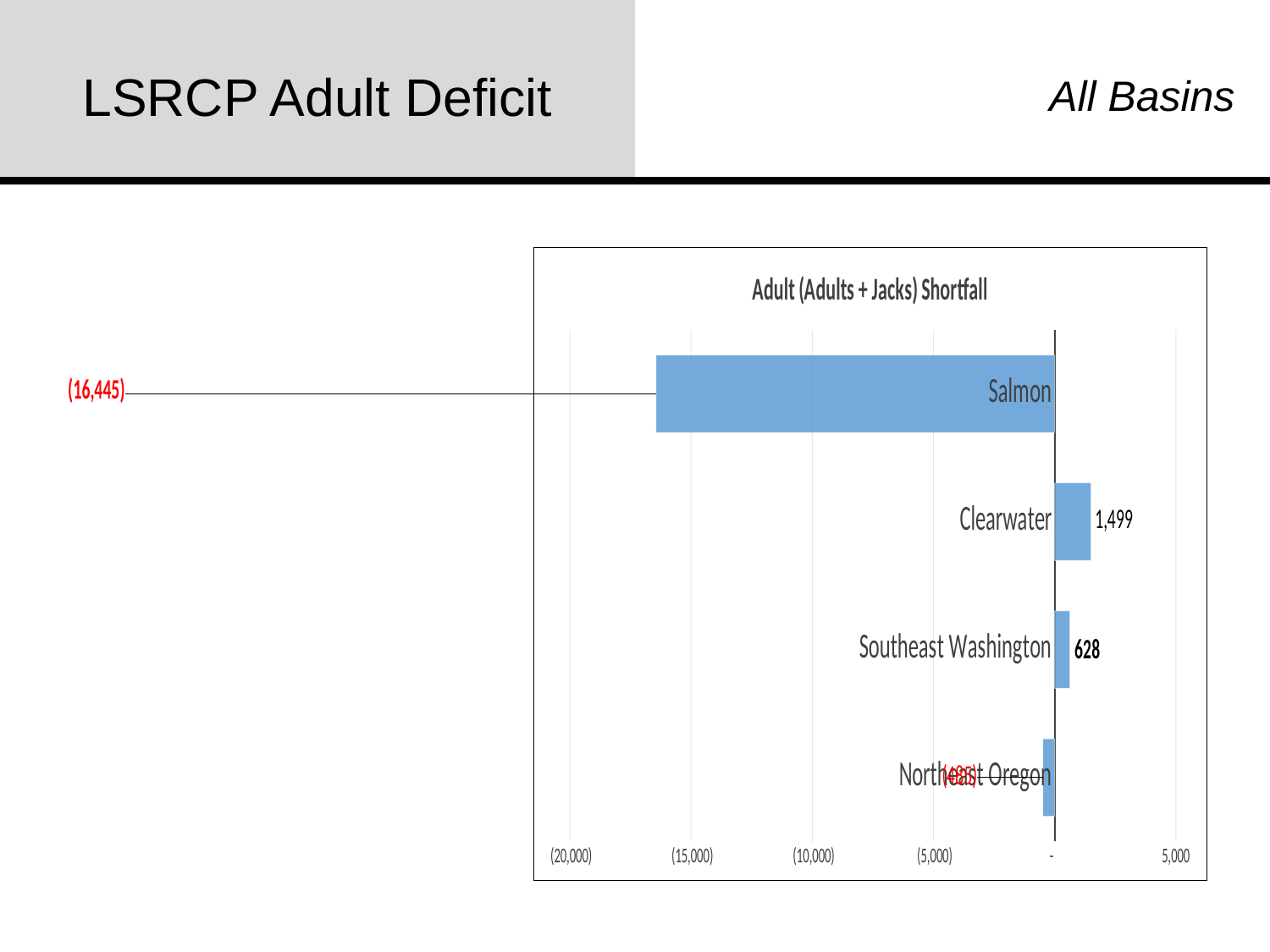
Is the value for Salmon greater or less than (15,000)? less Which basin has the highest value in the Adult (Adults + Jacks) Shortfall chart? Clearwater Is the value for Clearwater greater or less than 5,000? less What is the title of the chart on the slide? Adult (Adults + Jacks) Shortfall What is the value for Southeast Washington in the Adult (Adults + Jacks) Shortfall chart? 628 What is the difference between the values for Clearwater and Southeast Washington? 871 Which basin has the lowest value in the Adult (Adults + Jacks) Shortfall chart? Salmon What is the value for Clearwater in the Adult (Adults + Jacks) Shortfall chart? 1,499 What is the value for Salmon in the Adult (Adults + Jacks) Shortfall chart? (16,445) Which is larger, the value for Clearwater or the value for Southeast Washington? Clearwater How many basins are shown in the Adult (Adults + Jacks) Shortfall chart? 4 What kind of chart is shown on the slide? Bar chart